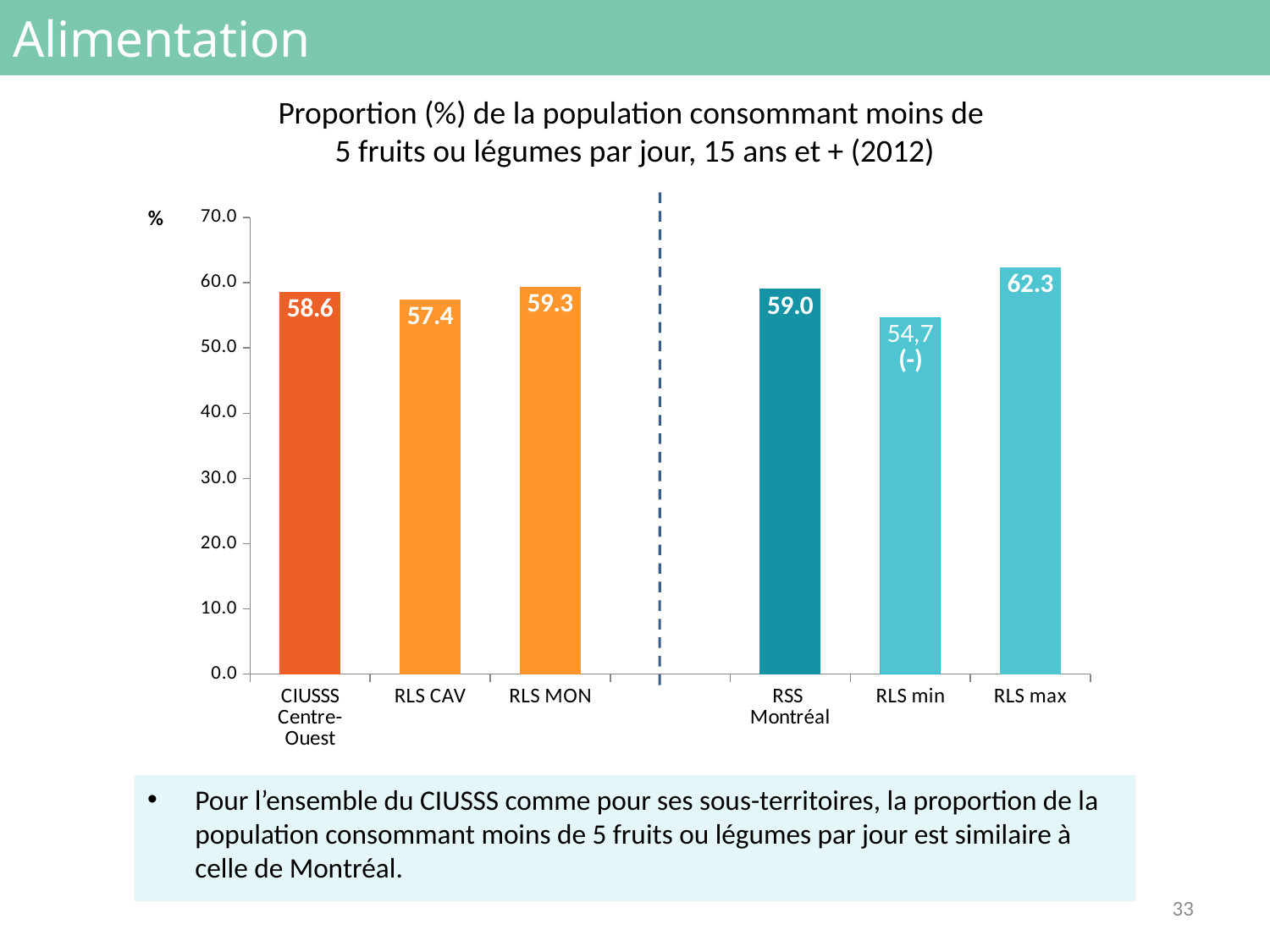
Is the value for RLS min greater or less than 50.0? greater Which is larger, the value for RLS MON or the value for RLS CAV? RLS MON Which category has the lowest value? RLS min What is the value for CIUSSS Centre-Ouest? 58.6 What is the value for RLS MON? 59.3 Which category has the highest value? RLS max What kind of chart is shown on the slide? Bar chart What is the difference between the values for RLS max and RSS Montréal? 3.3 What is the value for RSS Montréal? 59.0 What is the value for RLS CAV? 57.4 How many categories are shown on the x axis? 6 What is the value for RLS max? 62.3